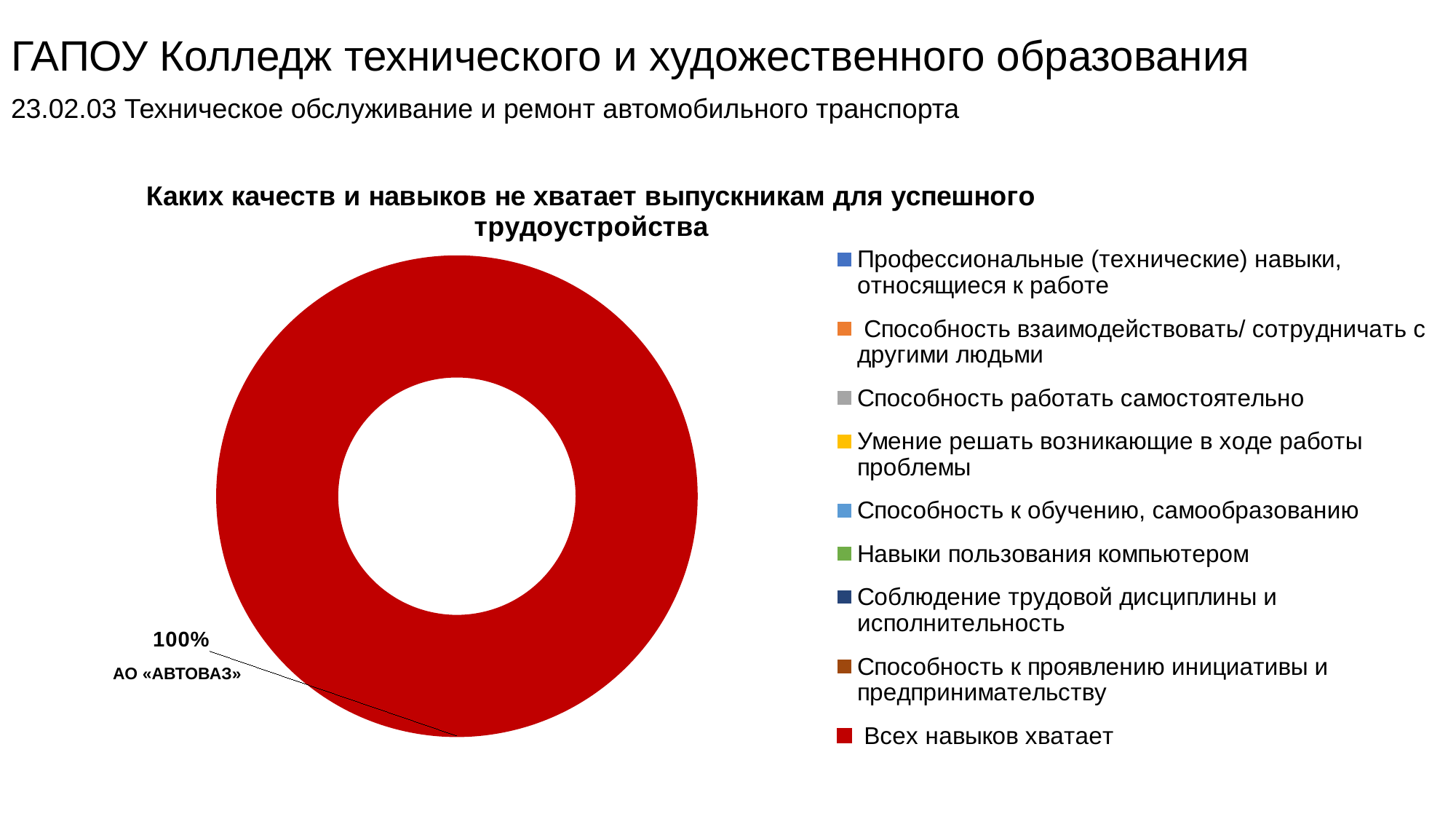
How many slices are visibly plotted in the doughnut chart? 1 What kind of chart is shown on the slide? doughnut chart What is the title of the chart? Каких качеств и навыков не хватает выпускникам для успешного трудоустройства What organisation name is printed next to the 100% data label? АО «АВТОВАЗ» What colour is the slice for "Всех навыков хватает"? red Is the share for "Всех навыков хватает" greater or less than 50%? greater What share of the doughnut chart does the category "Всех навыков хватает" represent? 100% How many entries does the legend of the chart list? 9 Which category accounts for the entire doughnut chart? Всех навыков хватает What value is printed as the data label on the chart? 100%